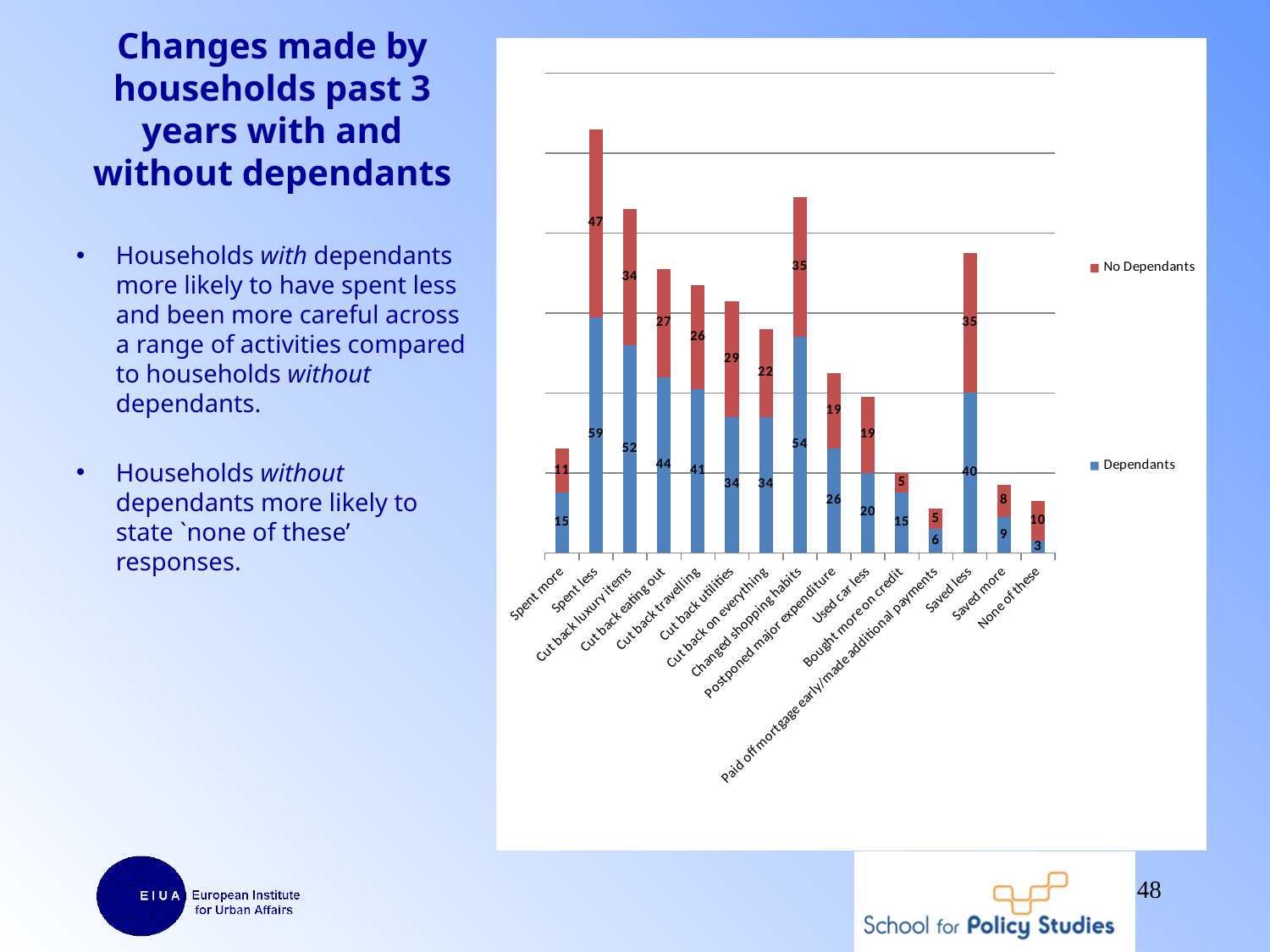
What is the total of the stacked bar for 'Spent less'? 106 What kind of chart is shown on the slide? stacked bar chart What is the Dependants value for 'Spent less'? 59 How many categories are shown on the x axis? 15 What is the Dependants value for 'None of these'? 3 What is the difference between the Dependants and No Dependants values for 'Cut back luxury items'? 18 Which series is shown in red? No Dependants Which category has the highest Dependants value? Spent less What is the No Dependants value for 'Changed shopping habits'? 35 Which is larger for 'None of these': the Dependants value or the No Dependants value? No Dependants How many series does the legend list? 2 Which category has the lowest Dependants value? None of these